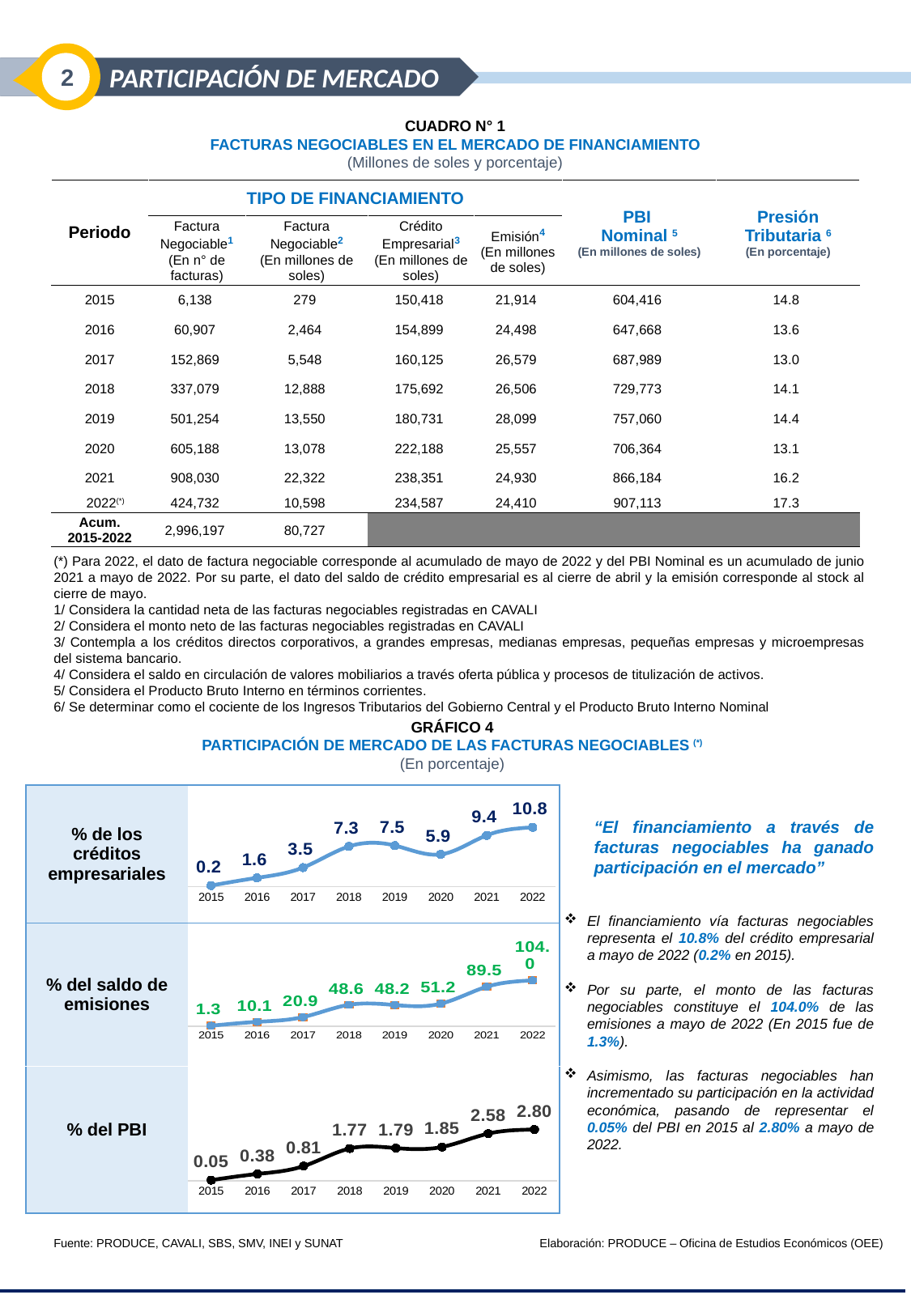
In Gráfico 4, what is the difference between the 2022 and 2015 values in the '% de los créditos empresariales' panel? 10.6 In Gráfico 4, which year has the lowest value in the '% del PBI' panel? 2015 In Gráfico 4, do the values in the '% del PBI' panel generally rise or fall from 2015 to 2022? Rise In Gráfico 4, in the '% de los créditos empresariales' panel, which is larger: the value for 2019 or the value for 2020? 2019 In Gráfico 4, which year has the highest value in the '% del saldo de emisiones' panel? 2022 In Gráfico 4, what is the value for 2015 in the '% del saldo de emisiones' panel? 1.3 In Gráfico 4, what is the value for 2019 in the '% del PBI' panel? 1.79 In Gráfico 4, what is the difference between the 2021 and 2020 values in the '% del saldo de emisiones' panel? 38.3 In Gráfico 4, what is the value for 2022 in the '% de los créditos empresariales' panel? 10.8 In Gráfico 4, how many years are plotted in each panel? 8 What kind of chart is Gráfico 4? Line chart What is the title of Gráfico 4? PARTICIPACIÓN DE MERCADO DE LAS FACTURAS NEGOCIABLES